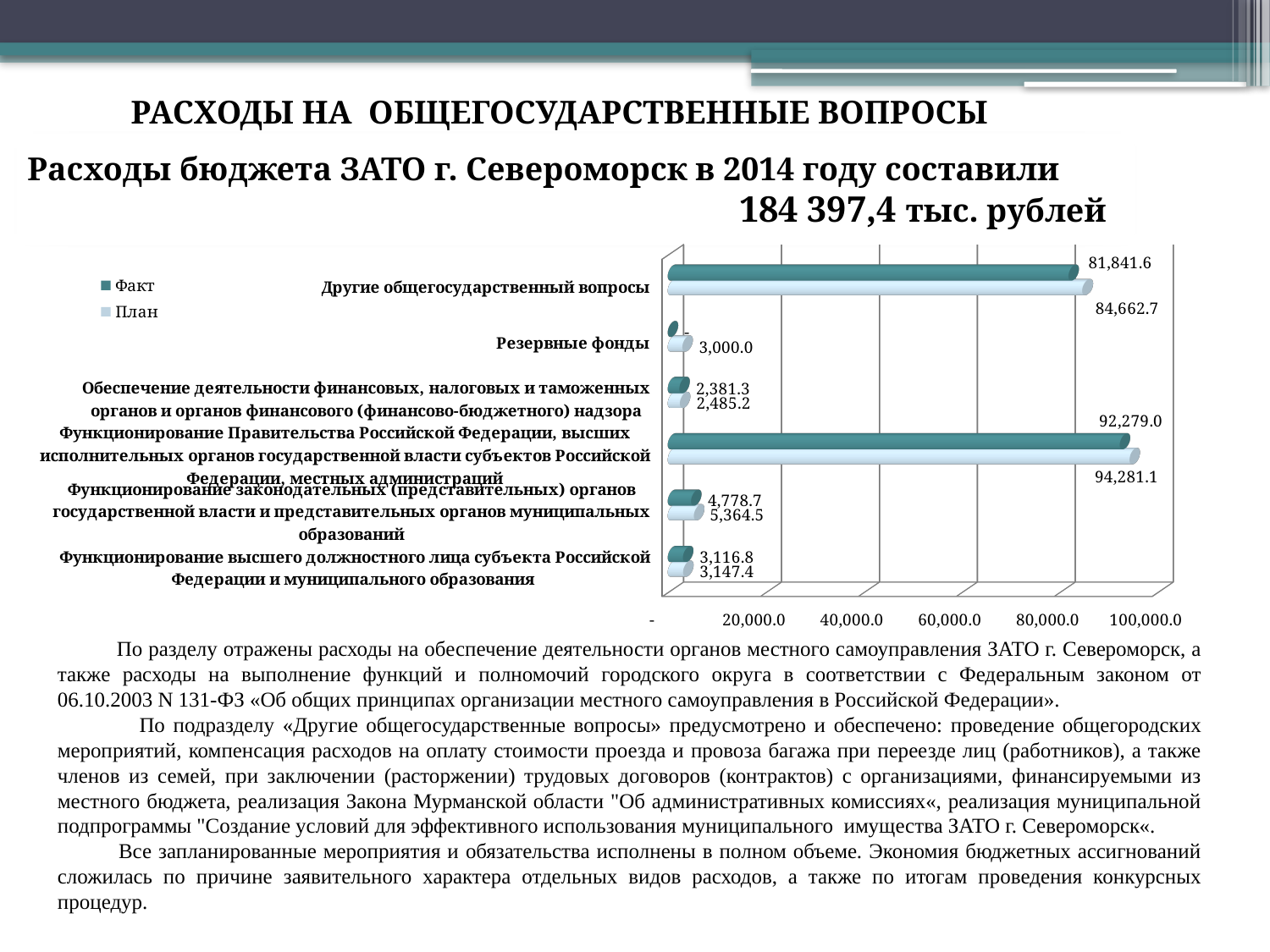
What is the План value for Резервные фонды? 3,000.0 What is the Факт value for Функционирование высшего должностного лица субъекта Российской Федерации и муниципального образования? 3,116.8 What is the difference between the План and Факт values for Функционирование законодательных (представительных) органов государственной власти и представительных органов муниципальных образований? 585.8 How many series does the legend list? 2 What is the План value for Функционирование Правительства Российской Федерации, высших исполнительных органов государственной власти субъектов Российской Федерации, местных администраций? 94,281.1 Which category has the highest Факт value? Функционирование Правительства Российской Федерации, высших исполнительных органов государственной власти субъектов Российской Федерации, местных администраций Is the Факт value for Другие общегосударственный вопросы greater or less than 80,000.0? greater Which category has the lowest План value? Обеспечение деятельности финансовых, налоговых и таможенных органов и органов финансового (финансово-бюджетного) надзора Which is larger for Обеспечение деятельности финансовых, налоговых и таможенных органов: the Факт value or the План value? План How many categories are shown in the chart? 6 What is the Факт value for Другие общегосударственный вопросы? 81,841.6 What is the difference between the План and Факт values for Другие общегосударственный вопросы? 2,821.1